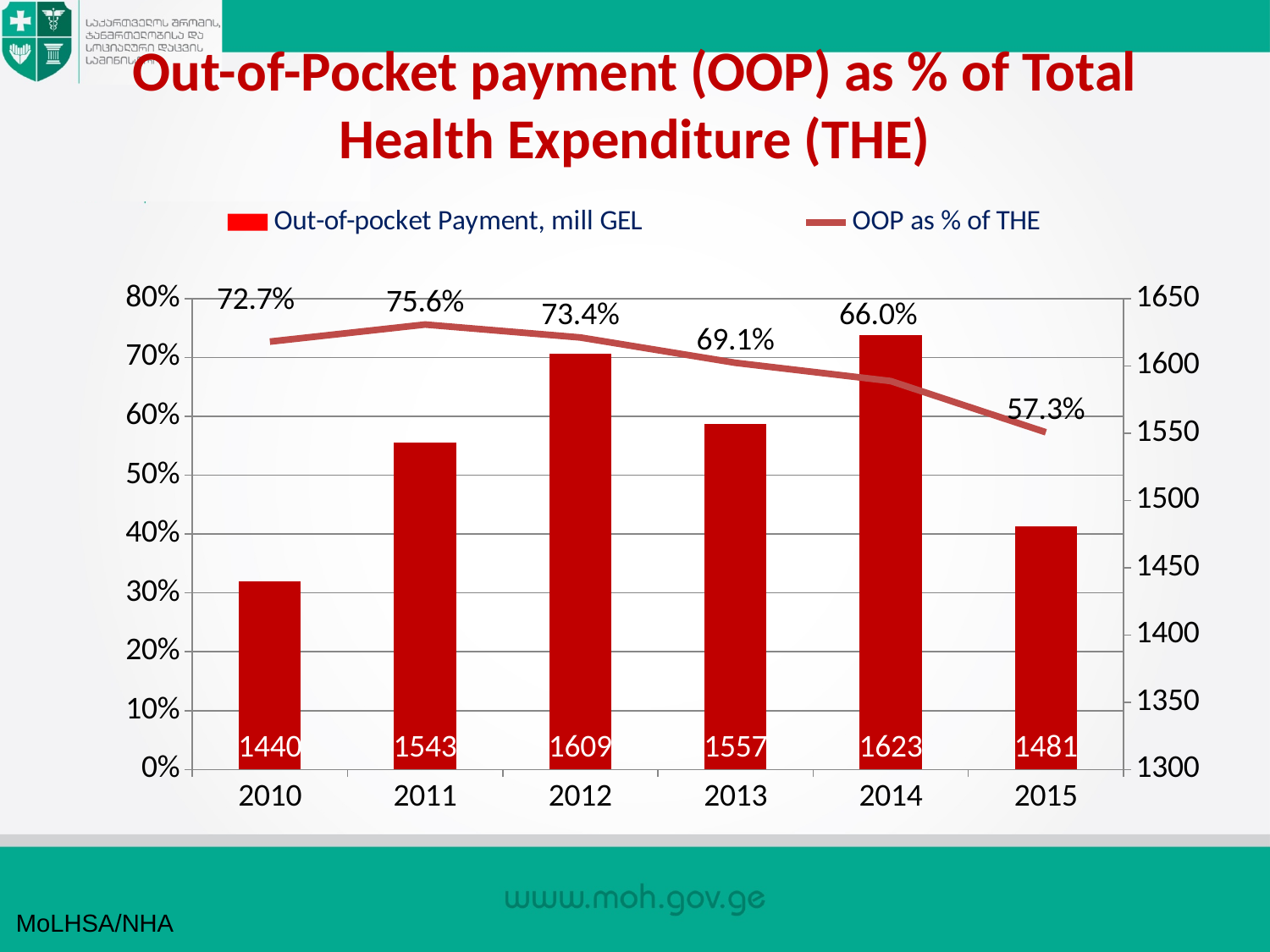
In which year was OOP as % of THE highest? 2011 How many series does the legend list? 2 In which year was OOP as % of THE lowest? 2015 In which year was the Out-of-pocket Payment (mill GEL) highest? 2014 What was the Out-of-pocket Payment in mill GEL in 2012? 1609 How many years are shown on the x axis? 6 What is the difference in Out-of-pocket Payment (mill GEL) between 2014 and 2015? 142 What was OOP as % of THE in 2015? 57.3% What kind of chart is used to show Out-of-pocket Payment, mill GEL? Bar chart Does OOP as % of THE rise or fall from 2011 to 2015? Fall Which year had a larger Out-of-pocket Payment in mill GEL, 2011 or 2013? 2013 By how many percentage points did OOP as % of THE fall from 2010 to 2015? 15.4